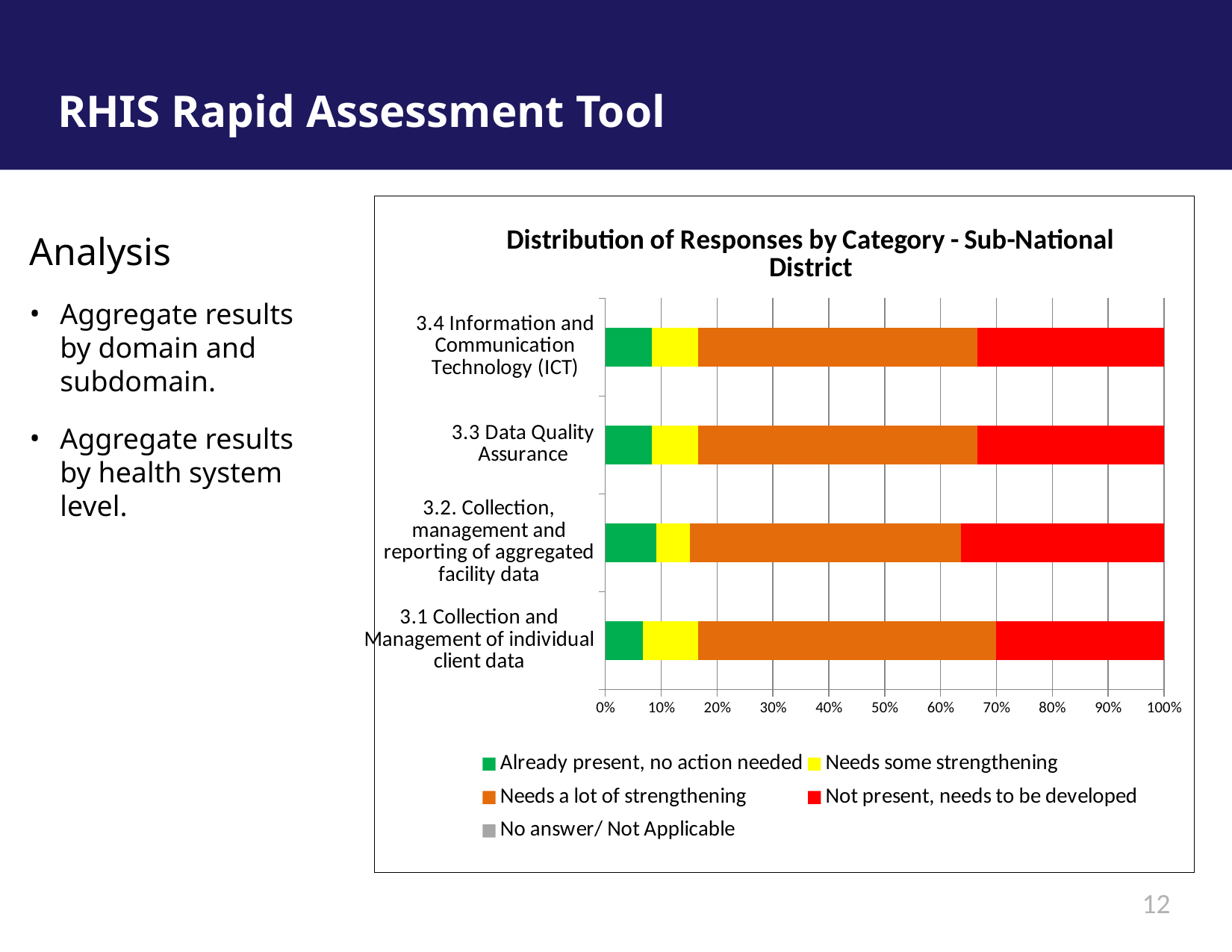
What is the title of the chart? Distribution of Responses by Category - Sub-National District Which category has the smallest 'Needs some strengthening' segment? 3.2. Collection, management and reporting of aggregated facility data Is the 'Not present, needs to be developed' share for 3.2. Collection, management and reporting of aggregated facility data greater or less than 30%? greater Is the 'Already present, no action needed' share for 3.1 Collection and Management of individual client data greater or less than 10%? less How many series does the chart legend list? 5 What kind of chart is shown on the slide? Stacked bar chart Which colour represents 'Not present, needs to be developed' in the chart? Red Is the 'Already present, no action needed' share for 3.4 Information and Communication Technology (ICT) greater or less than 10%? less Which has the larger 'Not present, needs to be developed' segment: 3.2. Collection, management and reporting of aggregated facility data or 3.1 Collection and Management of individual client data? 3.2. Collection, management and reporting of aggregated facility data Which category has the largest 'Not present, needs to be developed' segment? 3.2. Collection, management and reporting of aggregated facility data Which has the larger 'Needs some strengthening' segment: 3.1 Collection and Management of individual client data or 3.2. Collection, management and reporting of aggregated facility data? 3.1 Collection and Management of individual client data How many categories (subdomains) are plotted on the chart? 4